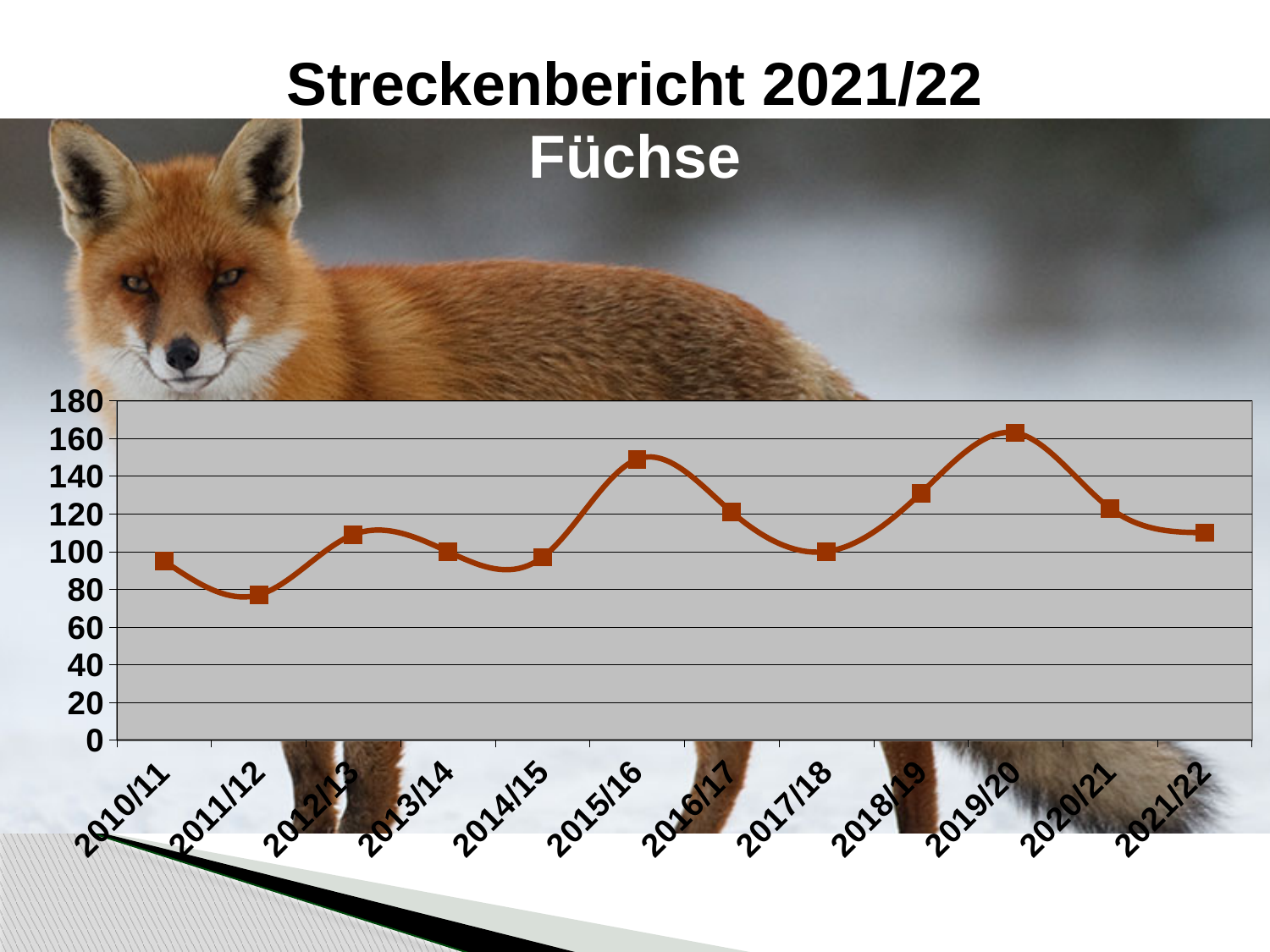
Which is larger, the value for 2018/19 or the value for 2019/20? 2019/20 Which season has the highest value? 2019/20 How many seasons (data points) are plotted on the x axis? 12 What kind of chart is shown on the slide? line chart Which is larger, the value for 2015/16 or the value for 2016/17? 2015/16 What is the title of the chart? Füchse Is the value for 2015/16 greater or less than 140? greater Which season has the lowest value? 2011/12 Do the values rise or fall from 2017/18 to 2019/20? rise Is the value for 2019/20 greater or less than 140? greater Do the values rise or fall from 2019/20 to 2021/22? fall